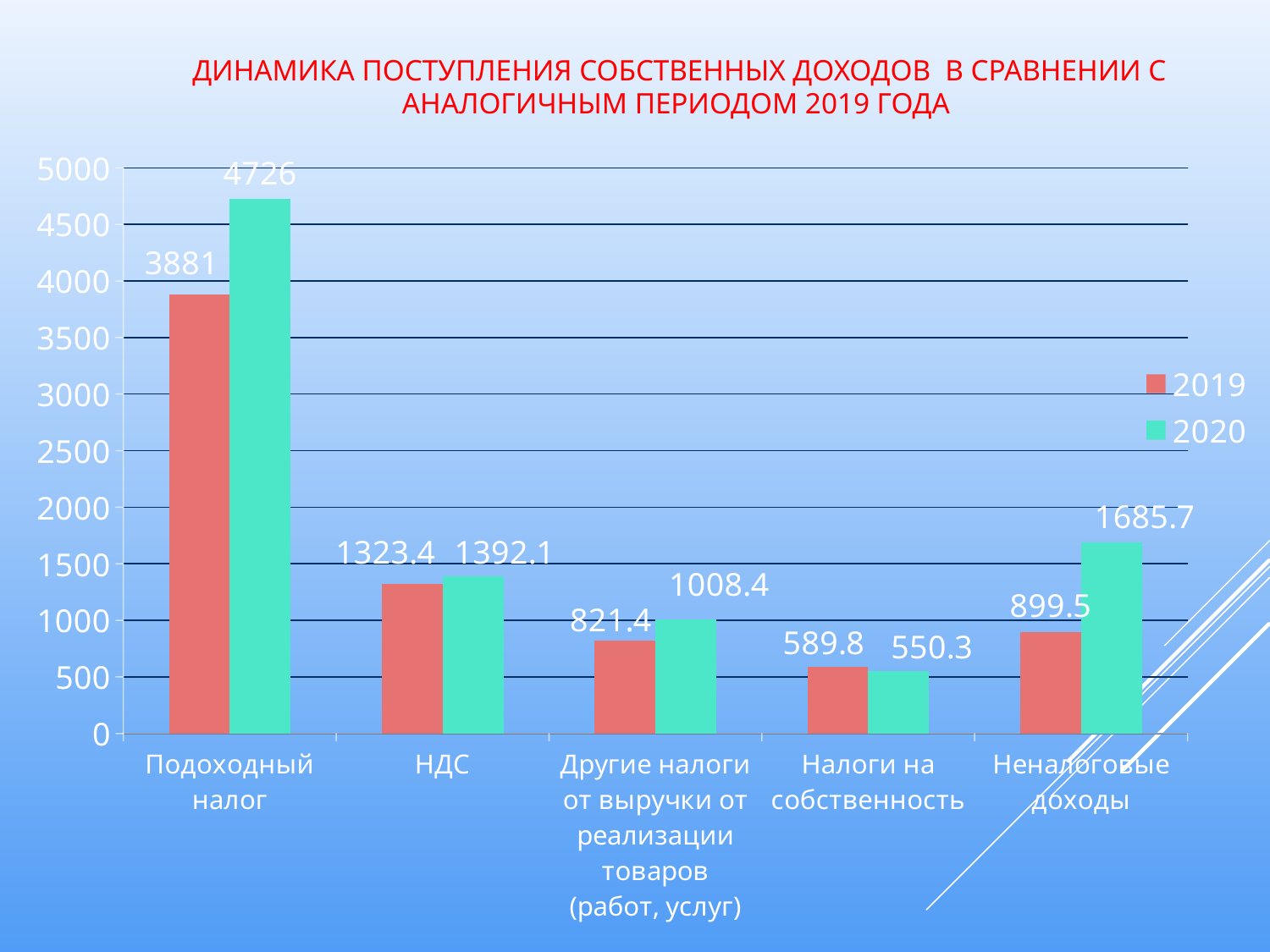
For Налоги на собственность, which year has the larger value, 2019 or 2020? 2019 What is the 2020 value for Подоходный налог? 4726 What is the 2020 value for Неналоговые доходы? 1685.7 What is the 2019 value for Налоги на собственность? 589.8 What kind of chart is shown on the slide? Bar chart What is the 2019 value for НДС? 1323.4 Which category has the highest 2020 value? Подоходный налог Is the 2020 value for Другие налоги от выручки от реализации товаров (работ, услуг) greater or less than 1000? greater What is the difference between the 2020 and 2019 values for Подоходный налог? 845 How many series does the legend list? 2 Which category has the lowest 2019 value? Налоги на собственность How many categories are shown on the x axis? 5